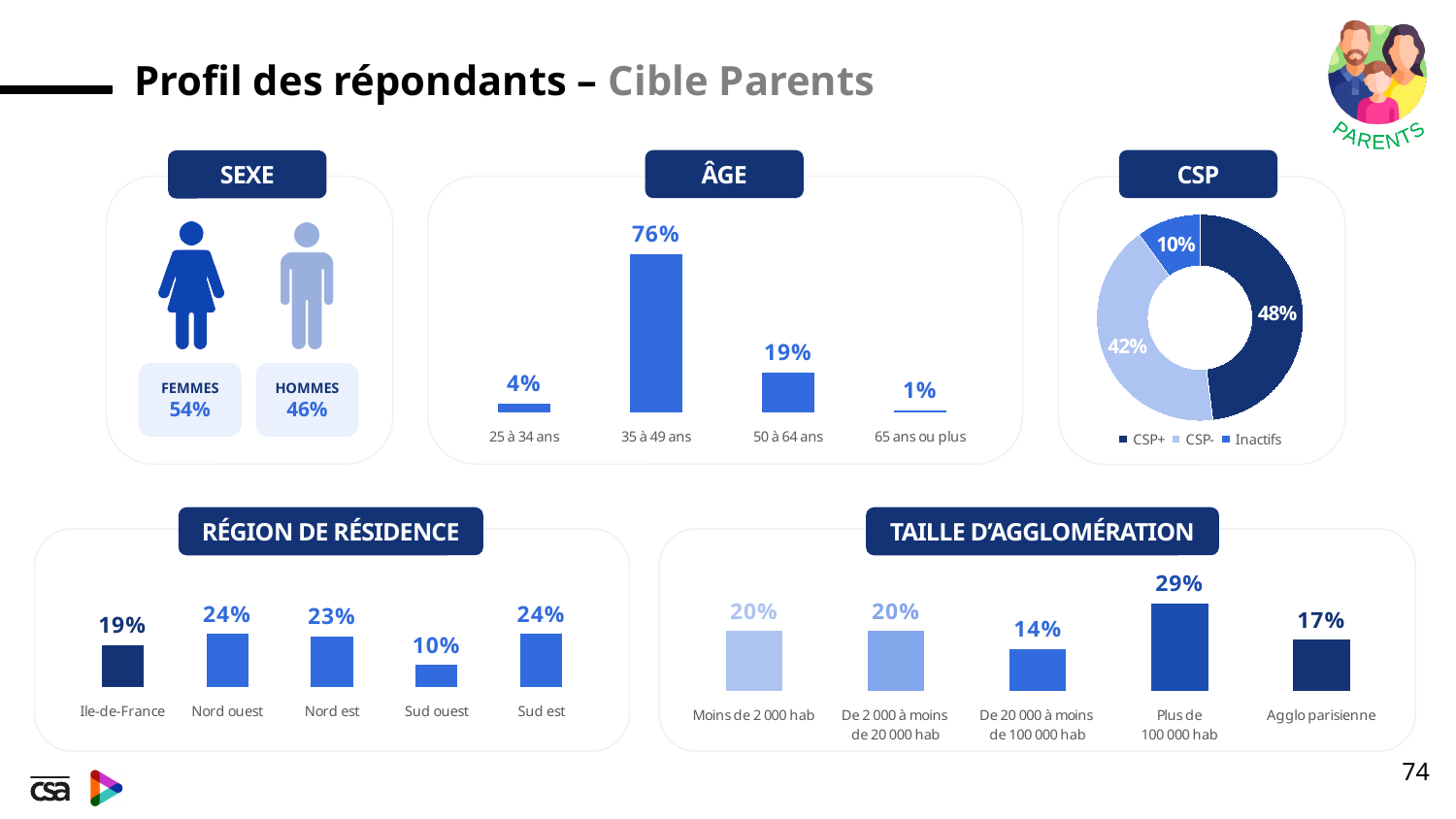
In the TAILLE D'AGGLOMÉRATION chart, what is the difference between Plus de 100 000 hab and Agglo parisienne? 12% What kind of chart is the ÂGE chart? Bar chart In the ÂGE chart, what is the difference between 35 à 49 ans and 50 à 64 ans? 57% In the ÂGE chart, what is the value for 35 à 49 ans? 76% In the CSP chart, how many series does the legend list? 3 In the TAILLE D'AGGLOMÉRATION chart, which category has the highest value? Plus de 100 000 hab In the RÉGION DE RÉSIDENCE chart, which is larger, Ile-de-France or Nord est? Nord est What kind of chart is the CSP chart? Pie chart (donut) In the CSP chart, what share of the pie is CSP-? 42% In the ÂGE chart, which age group has the lowest value? 65 ans ou plus In the RÉGION DE RÉSIDENCE chart, how many categories are shown? 5 In the RÉGION DE RÉSIDENCE chart, what is the value for Sud ouest? 10%